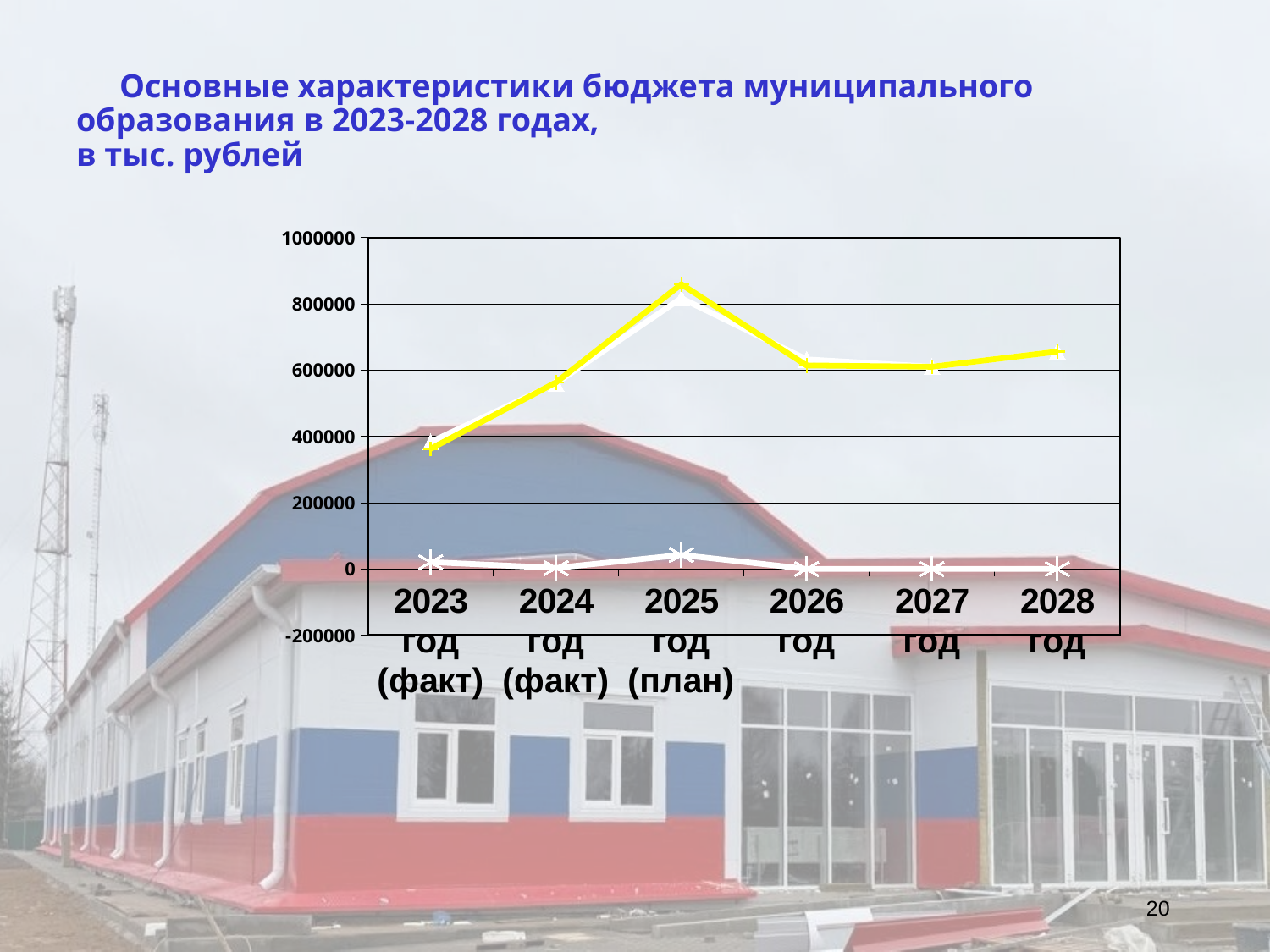
What is the lowest tick value shown on the vertical axis of the chart? -200000 Is the value of the yellow line for 2024 год (факт) greater or less than 400000? greater Does the yellow line rise or fall from 2023 год (факт) to 2025 год (план)? rises Is the value of the yellow line for 2025 год (план) greater or less than 800000? greater Is the value of the yellow line for 2026 год greater or less than 400000? greater Which is larger on the yellow line: the value for 2025 год (план) or the value for 2028 год? 2025 год (план) What type of chart is shown on the slide? line chart In which year does the yellow line reach its highest value? 2025 год (план) In which year does the line with asterisk markers reach its highest point? 2025 год (план) In which year does the yellow line have its lowest value? 2023 год (факт) How many years (categories) are plotted along the x axis of the chart? 6